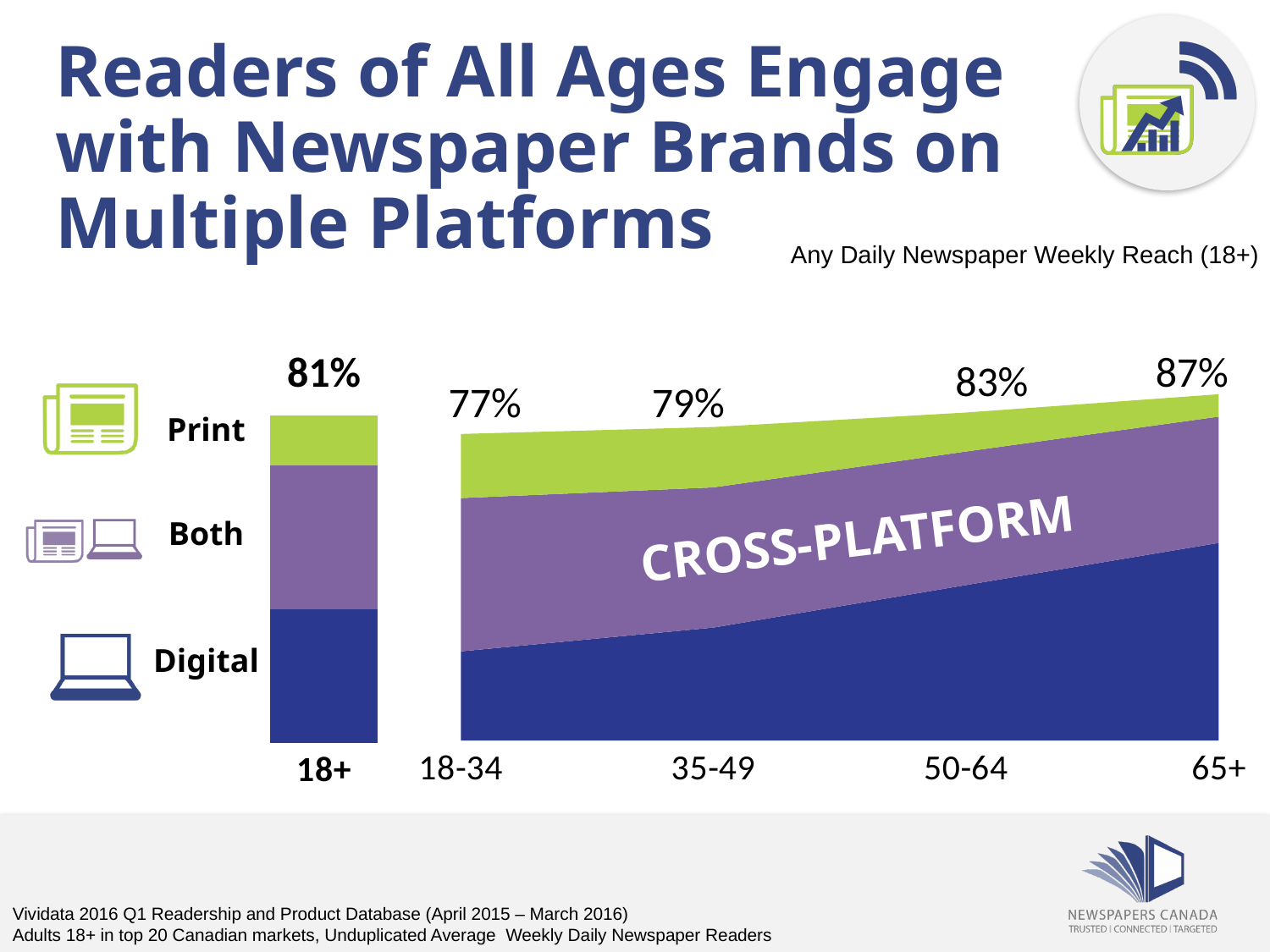
How many series (platform categories) does the legend list for the charts? 3 In the area chart on the right, what is the total weekly reach for the 50-64 age group? 83% In the area chart on the right, what is the difference in total weekly reach between the 65+ and 18-34 age groups? 10% How many age groups are shown along the x axis of the area chart on the right? 4 In the area chart on the right, which has the larger total weekly reach, 35-49 or 50-64? 50-64 In the area chart on the right, does total weekly reach rise or fall as age group increases from 18-34 to 65+? rises In the area chart on the right, which age group has the highest total weekly reach? 65+ In the area chart on the right, which age group has the lowest total weekly reach? 18-34 In the area chart on the right, what is the total weekly reach for the 18-34 age group? 77% In the area chart on the right, what is the total weekly reach for the 65+ age group? 87% In the bar chart on the left, what is the total weekly reach for adults 18+? 81% Which platform category is shown in green in the charts? Print